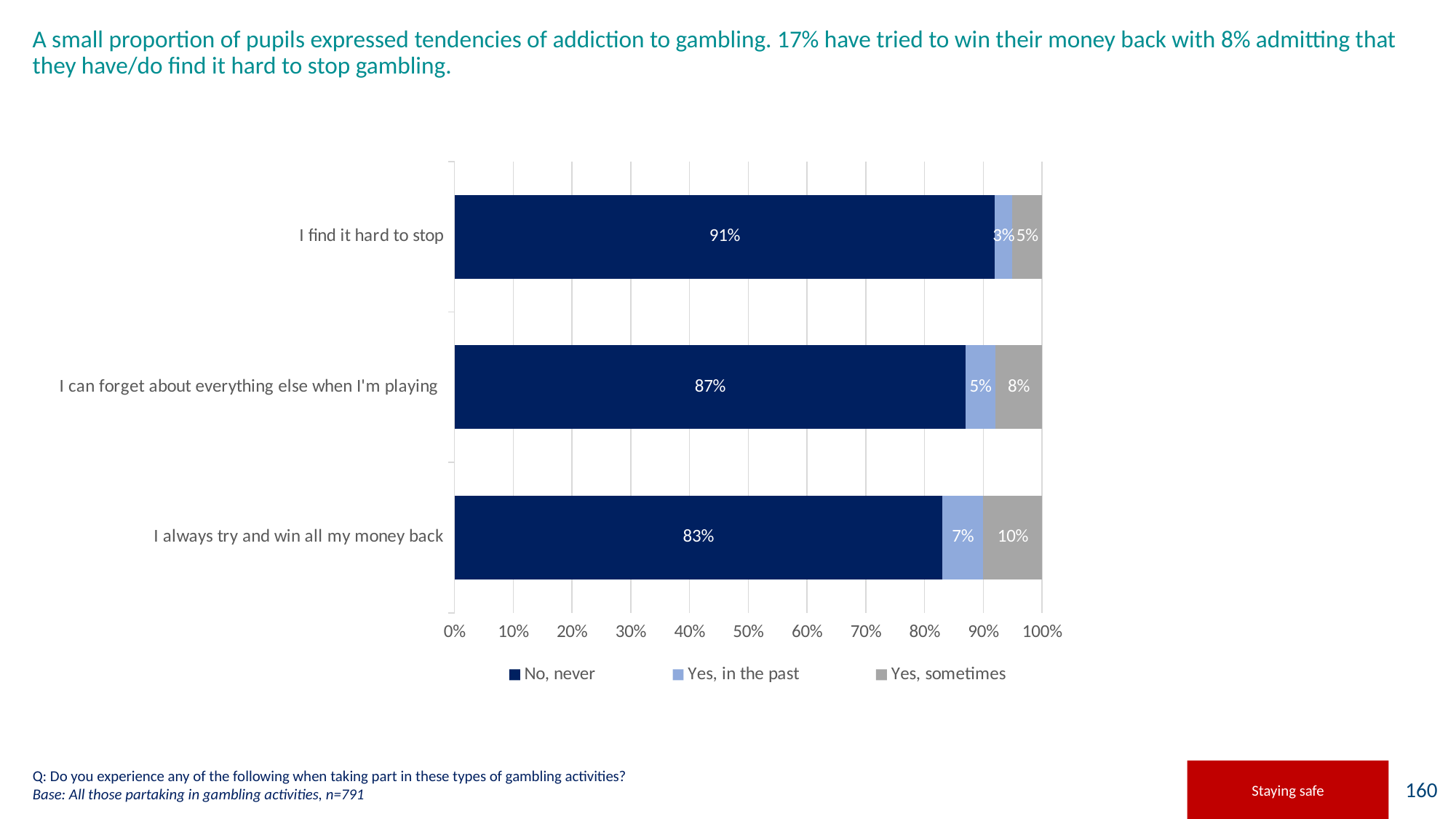
What is the combined percentage of "Yes, in the past" and "Yes, sometimes" for "I always try and win all my money back"? 17% Is the "No, never" value for "I can forget about everything else when I'm playing" greater or less than 80%? greater What percentage of pupils answered "No, never" for "I find it hard to stop"? 91% What kind of chart is shown on the slide? Stacked bar chart Which statement has the lowest "Yes, sometimes" percentage? I find it hard to stop How many statements are shown on the chart? 3 What percentage of pupils answered "Yes, sometimes" for "I always try and win all my money back"? 10% What percentage of pupils answered "Yes, in the past" for "I can forget about everything else when I'm playing"? 5% How many series does the legend list? 3 What is the difference between the "No, never" percentages for "I find it hard to stop" and "I always try and win all my money back"? 8% Which statement has the highest "No, never" percentage? I find it hard to stop Which is larger: the "Yes, in the past" value for "I always try and win all my money back" or for "I find it hard to stop"? I always try and win all my money back